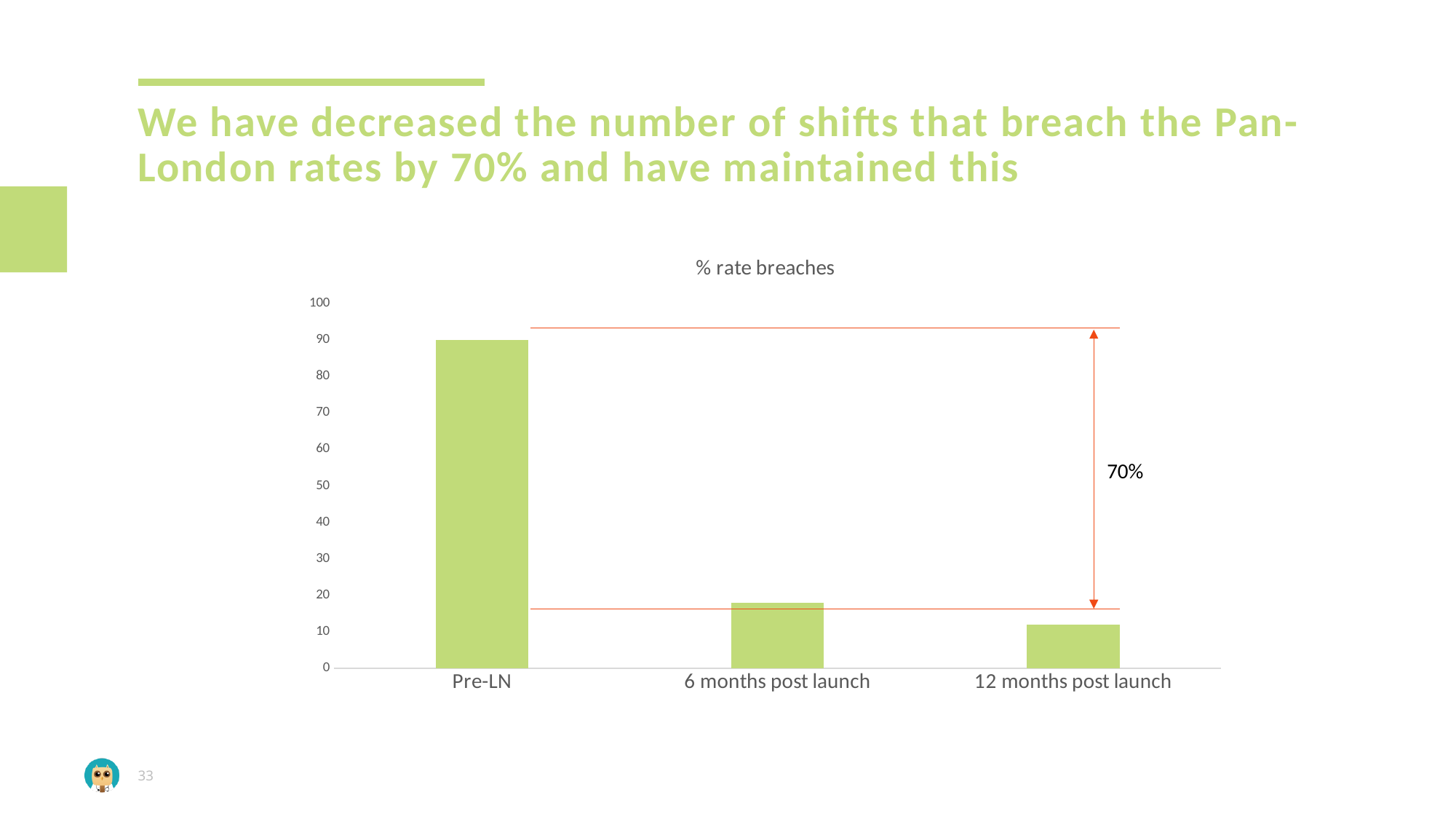
Which category has the highest % rate breaches? Pre-LN Is the value for Pre-LN greater or less than 50? greater How many categories are plotted on the x axis? 3 What kind of chart is shown on the slide? bar chart What percentage decrease is labelled next to the arrow on the chart? 70% Which is larger, the value for Pre-LN or the value for 6 months post launch? Pre-LN Is the value for Pre-LN greater or less than 80? greater Do the values rise or fall from Pre-LN to 12 months post launch? fall Which category has the lowest % rate breaches? 12 months post launch What is the title of the chart? % rate breaches Is the value for 12 months post launch greater or less than 20? less